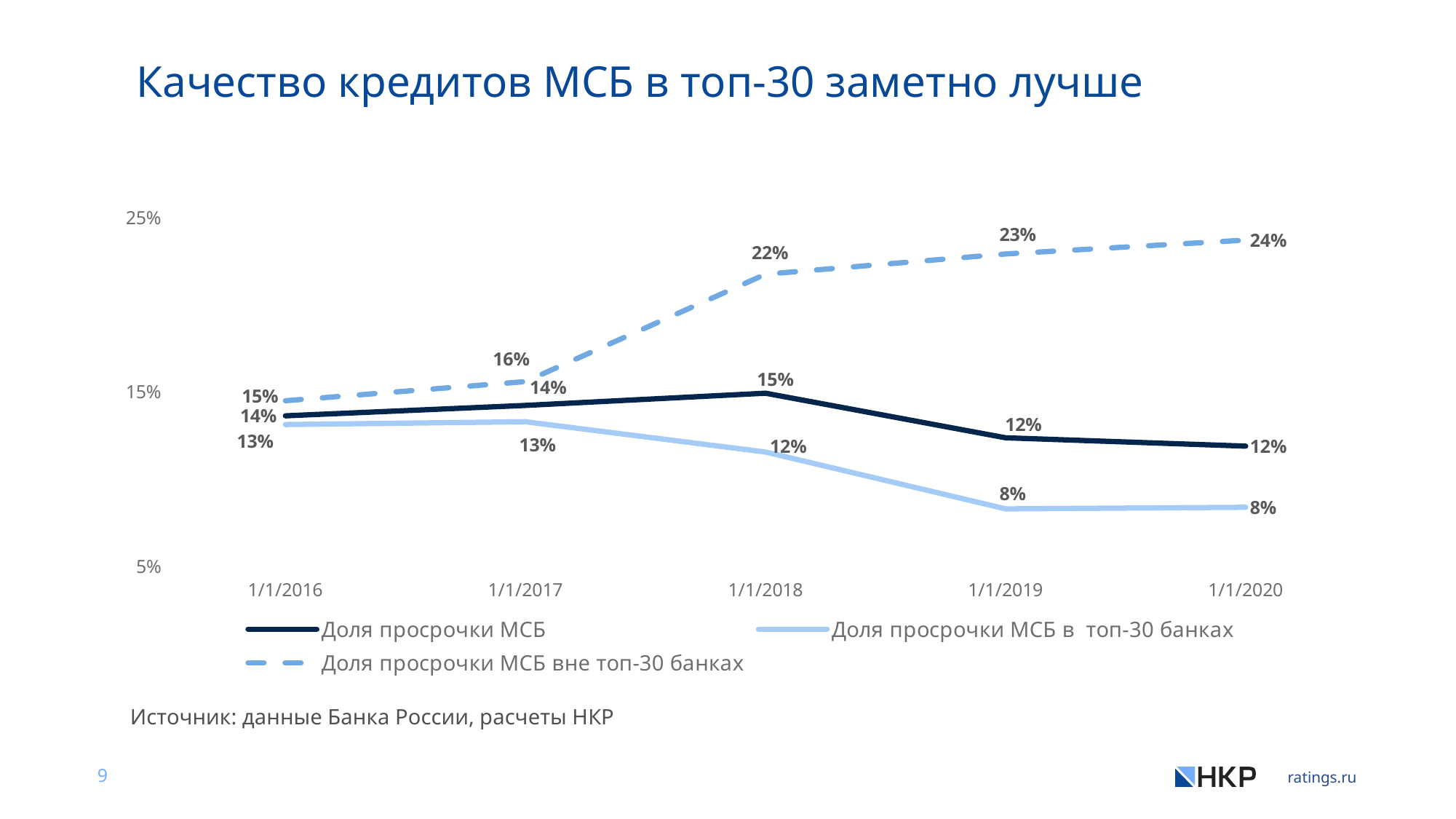
Does 'Доля просрочки МСБ вне топ-30 банках' rise or fall from 1/1/2016 to 1/1/2020? rise What is the title of the chart on the slide? Качество кредитов МСБ в топ-30 заметно лучше What is the value of 'Доля просрочки МСБ вне топ-30 банках' at 1/1/2020? 24% What is the value of 'Доля просрочки МСБ в топ-30 банках' at 1/1/2019? 8% At which date is 'Доля просрочки МСБ вне топ-30 банках' highest? 1/1/2020 At which date is 'Доля просрочки МСБ' highest? 1/1/2018 What is the difference between 'Доля просрочки МСБ вне топ-30 банках' and 'Доля просрочки МСБ в топ-30 банках' at 1/1/2020? 16% What kind of chart is shown on the slide? line chart How many dates are shown on the x axis? 5 How many series does the legend list? 3 What is the value of 'Доля просрочки МСБ' at 1/1/2018? 15% Which series has the larger value at 1/1/2018: 'Доля просрочки МСБ' or 'Доля просрочки МСБ в топ-30 банках'? Доля просрочки МСБ